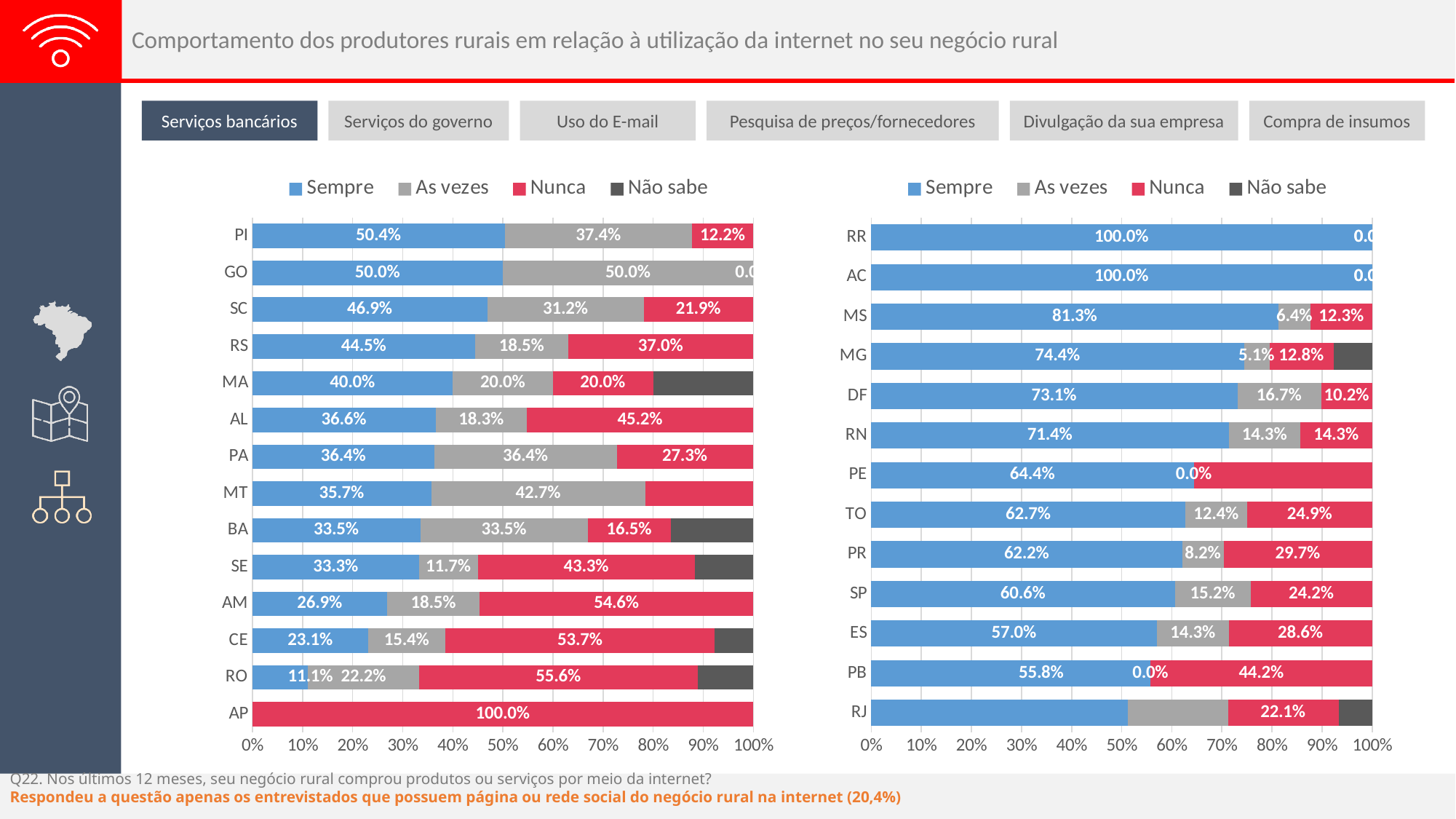
Which tab is highlighted at the top of the slide? Serviços bancários How many series does the legend of the right chart list? 4 In the left chart, what is the 'Sempre' value for PI? 50.4% In the right chart, which state has the highest 'Nunca' value? PB In the right chart, what is the 'Nunca' value for PB? 44.2% What kind of chart is used on this slide? Stacked bar chart In the left chart, what is the difference between the 'Nunca' and 'As vezes' values for RS? 18.5 percentage points In the left chart, which has the larger 'Nunca' value, AM or CE? AM How many states are shown in the left chart? 14 In the left chart, which state has the highest 'Nunca' value? AP In the right chart, what is the 'As vezes' value for DF? 16.7% In the right chart, is the 'Nunca' value for PE greater or less than 30%? greater